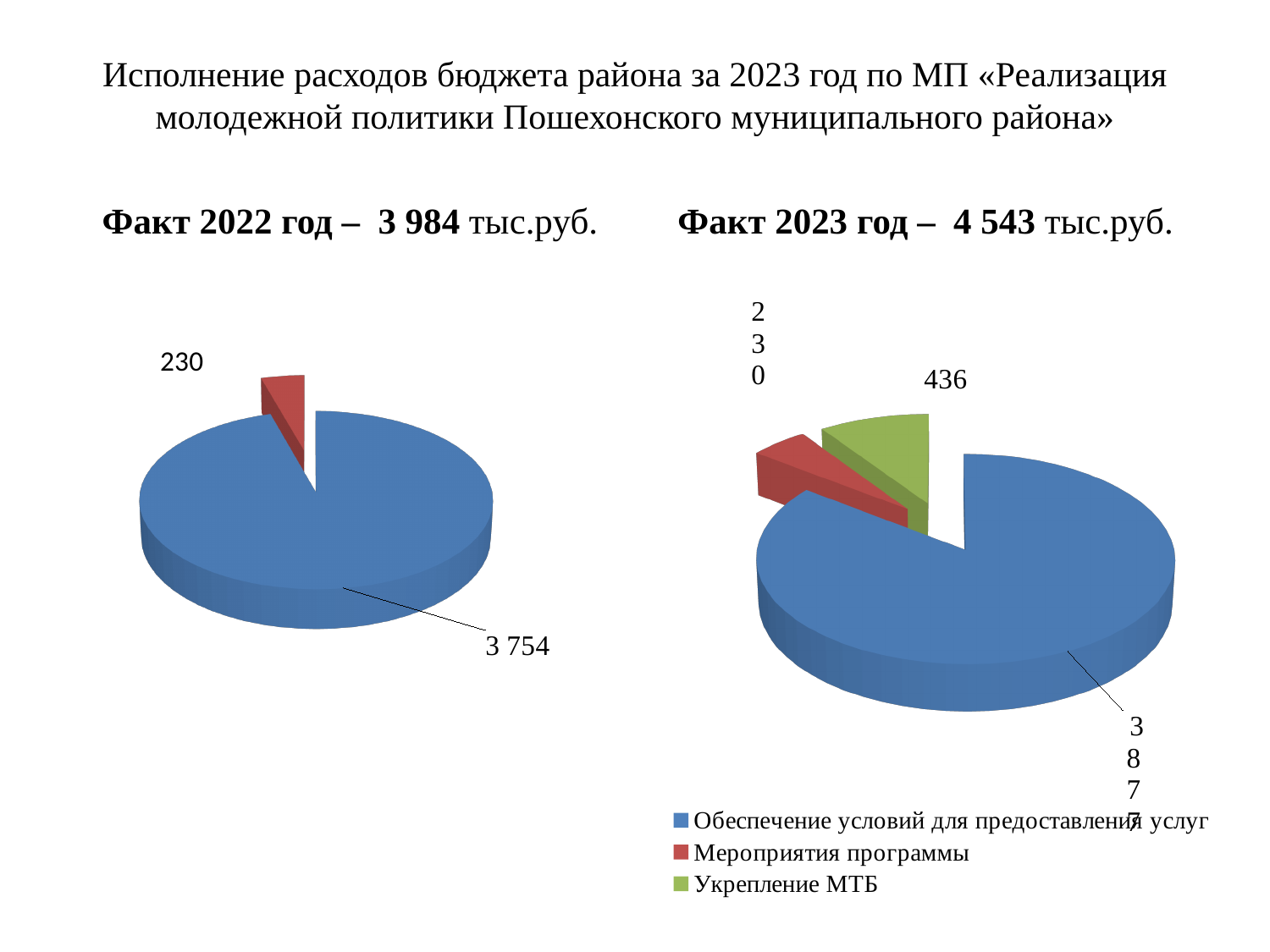
How many slices does the right chart (Факт 2023 год) have? 3 In the right chart (Факт 2023 год), what is the difference between Укрепление МТБ and Мероприятия программы? 206 In the left chart (Факт 2022 год), what is the difference between the blue slice and the red slice? 3 524 In the right chart (Факт 2023 год), what is the value for Мероприятия программы? 230 How many slices does the left chart (Факт 2022 год) have? 2 In the left chart (Факт 2022 год), what is the value of the large blue slice? 3 754 In the right chart (Факт 2023 год), what is the value for Укрепление МТБ? 436 In the right chart (Факт 2023 год), which category has the largest slice? Обеспечение условий для предоставления услуг What kind of charts are shown on the slide? Pie charts In the right chart (Факт 2023 год), which category has the smallest slice? Мероприятия программы How many entries does the legend of the right chart (Факт 2023 год) list? 3 In the left chart (Факт 2022 год), what is the value of the small red slice? 230